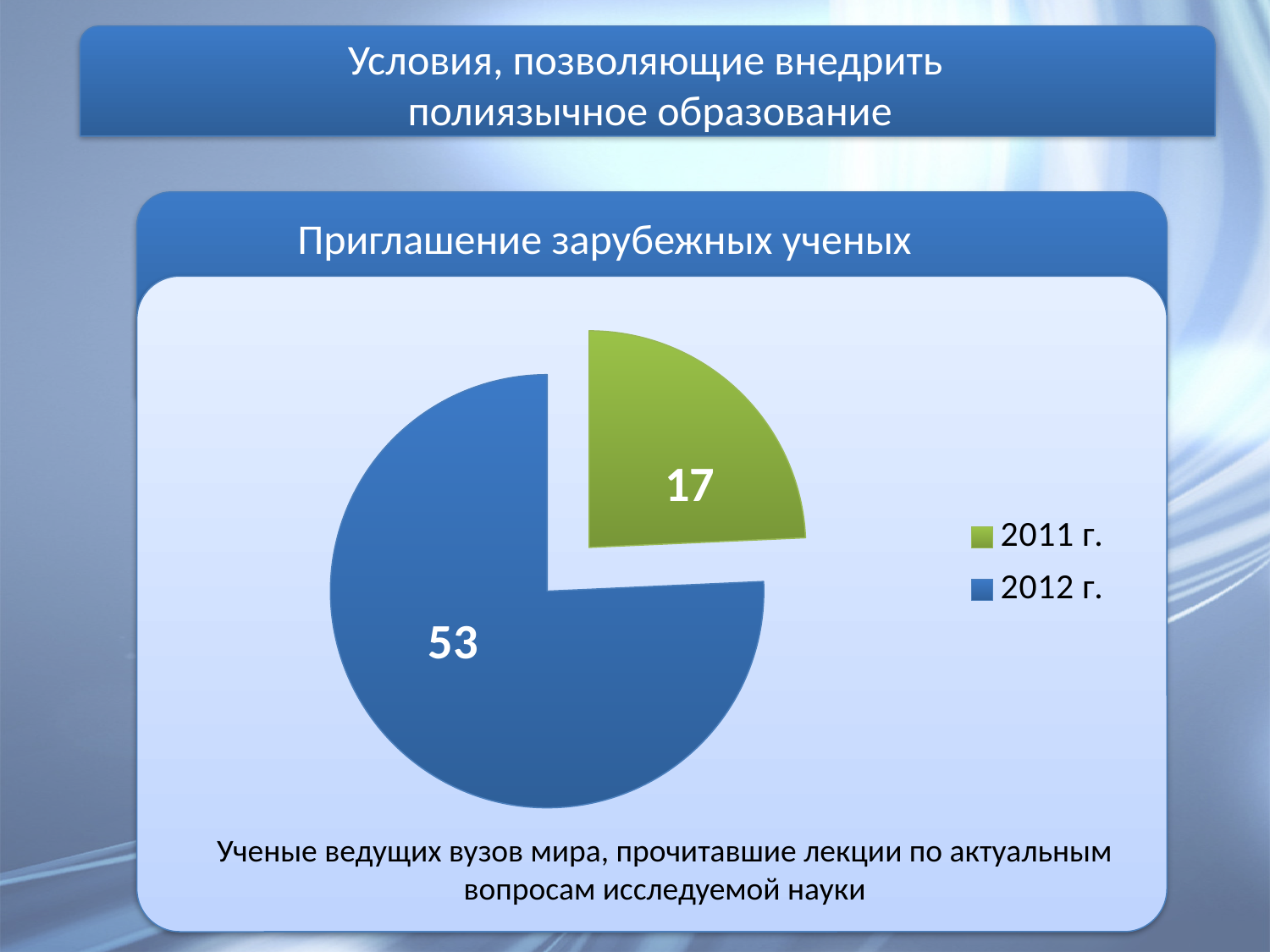
Is the value for 2011 г. larger or smaller than the value for 2012 г.? smaller How many slices does the pie chart have? 2 What is the total of the two values shown in the pie chart? 70 By how much does the value for 2012 г. exceed the value for 2011 г.? 36 What is the value for 2011 г. in the pie chart? 17 Which year has the smaller slice in the pie chart? 2011 г. What is the value for 2012 г. in the pie chart? 53 What type of chart is shown on the slide? pie chart What colour is the slice for 2011 г.? green Which year has the larger slice in the pie chart? 2012 г. To the nearest percent, what share of the total does the 2012 г. slice represent? 76% How many entries does the legend list? 2